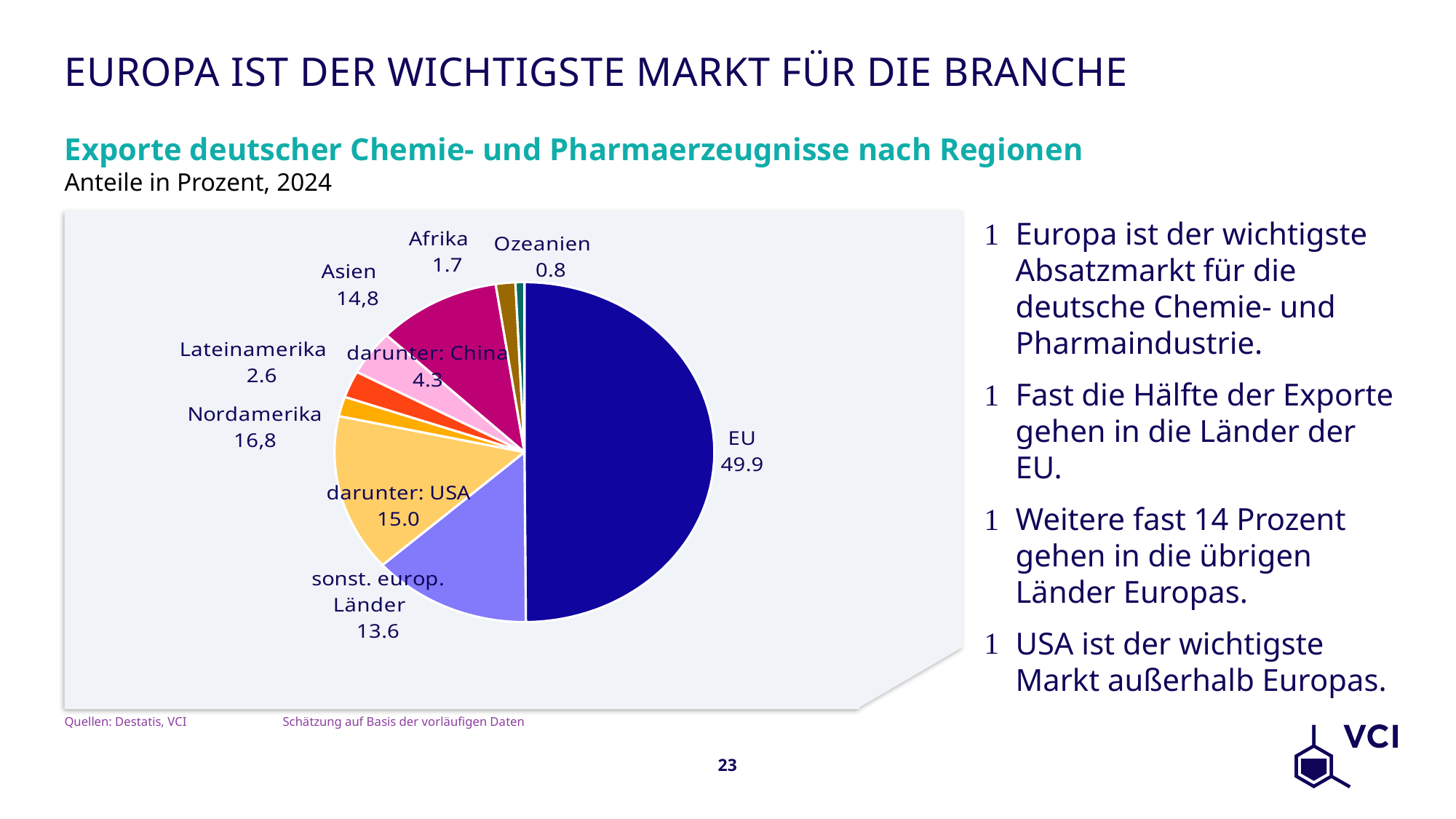
What is the value shown for Ozeanien? 0.8 What share of exports goes to the EU? 49.9 Which is larger, the share for Lateinamerika or the share for Afrika? Lateinamerika What is the difference between the value for 'darunter: China' and the value for Afrika? 2.6 Which region has the smallest share of exports? Ozeanien What is the difference between the EU share and the share of 'sonst. europ. Länder'? 36.3 What is the value shown for Asien? 14,8 What is the value shown for Nordamerika? 16,8 What is the title of the chart? Exporte deutscher Chemie- und Pharmaerzeugnisse nach Regionen Which region has the largest share of exports? EU What type of chart is shown on the slide? pie chart What is the value shown for 'darunter: USA'? 15.0